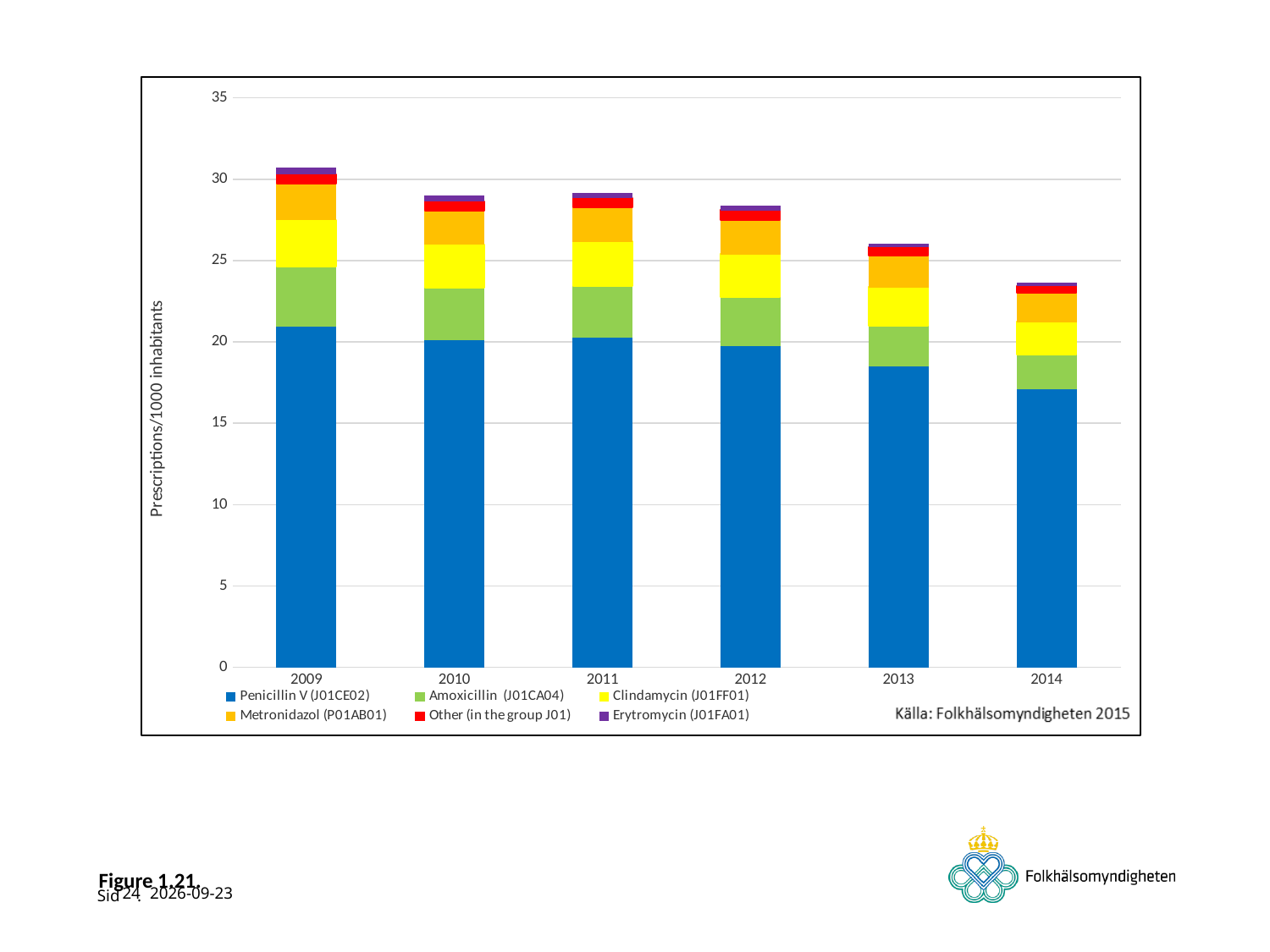
Which year has the highest total prescriptions per 1000 inhabitants? 2009 Which year has the larger total bar, 2012 or 2013? 2012 Is the total value for 2014 greater or less than 25? less How many series does the chart's legend list? 6 What kind of chart is shown on the slide? Stacked bar chart Is the Penicillin V (J01CE02) value for 2014 greater or less than 20? less How many years are shown on the x axis of the chart? 6 Which series is shown in blue in the chart's legend? Penicillin V (J01CE02) Is the total value for 2009 greater or less than 30? greater What is the label on the y axis of the chart? Prescriptions/1000 inhabitants Do the total bar heights rise or fall from 2009 to 2014? Fall Which year has the lowest total prescriptions per 1000 inhabitants? 2014